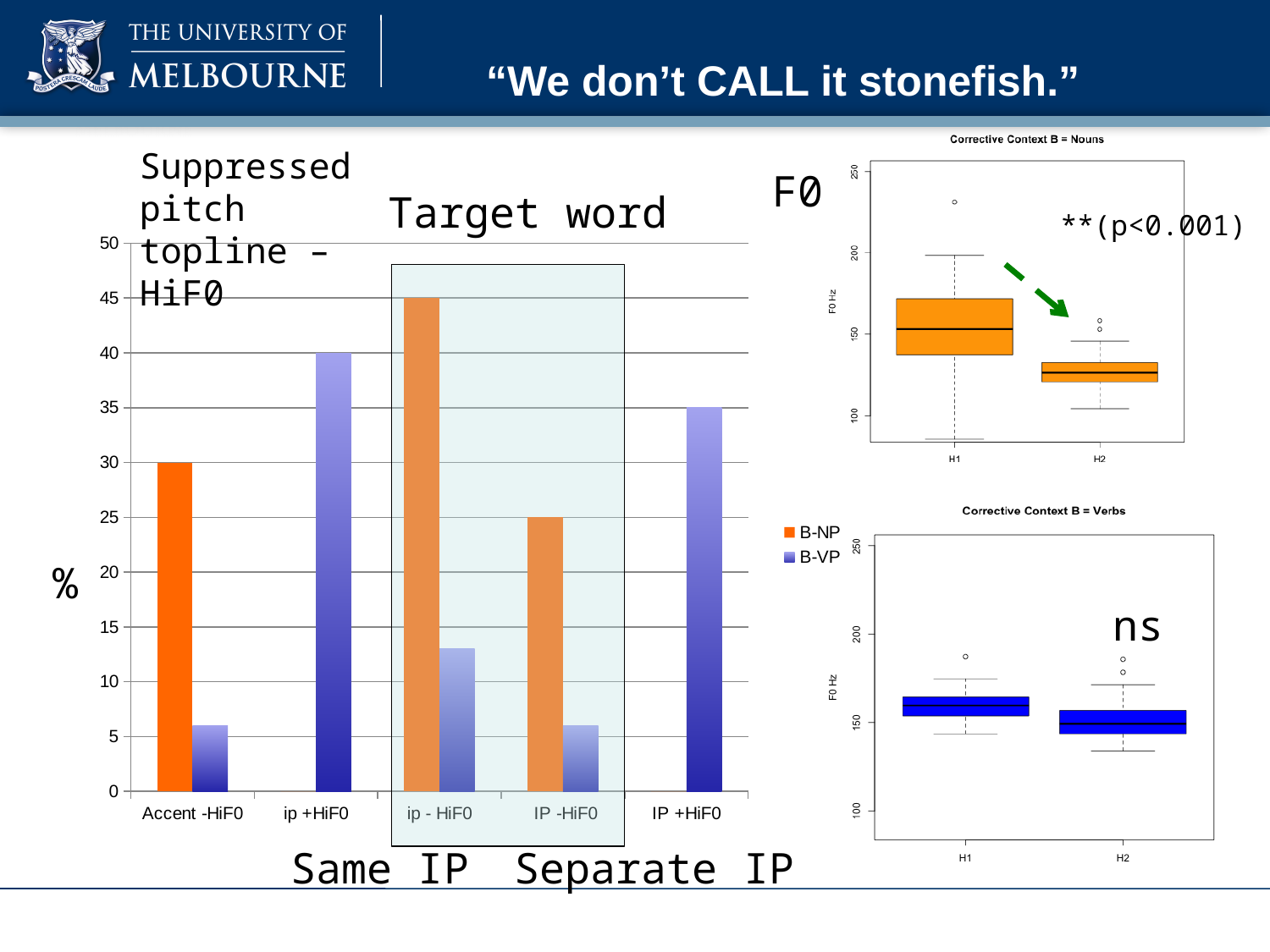
How many categories are shown on the x axis of the bar chart on the left? 5 In the bar chart on the left, what is the difference between the B-NP value for ip - HiF0 and the B-NP value for IP -HiF0? 20 In the bar chart on the left, which is larger: the B-VP value for ip +HiF0 or the B-VP value for IP +HiF0? ip +HiF0 In the bar chart on the left, what is the B-VP value for ip +HiF0? 40 What kind of chart is the chart titled "Corrective Context B = Nouns"? box plot In the bar chart on the left, which category has the highest B-NP value? ip - HiF0 In the bar chart on the left, what is the B-NP value for ip - HiF0? 45 In the bar chart on the left, what is the B-NP value for Accent -HiF0? 30 How many series does the legend of the bar chart on the left list? 2 In the bar chart on the left, is the B-VP value for ip - HiF0 greater or less than 10? greater In the bar chart on the left, is the B-VP value for Accent -HiF0 greater or less than 10? less